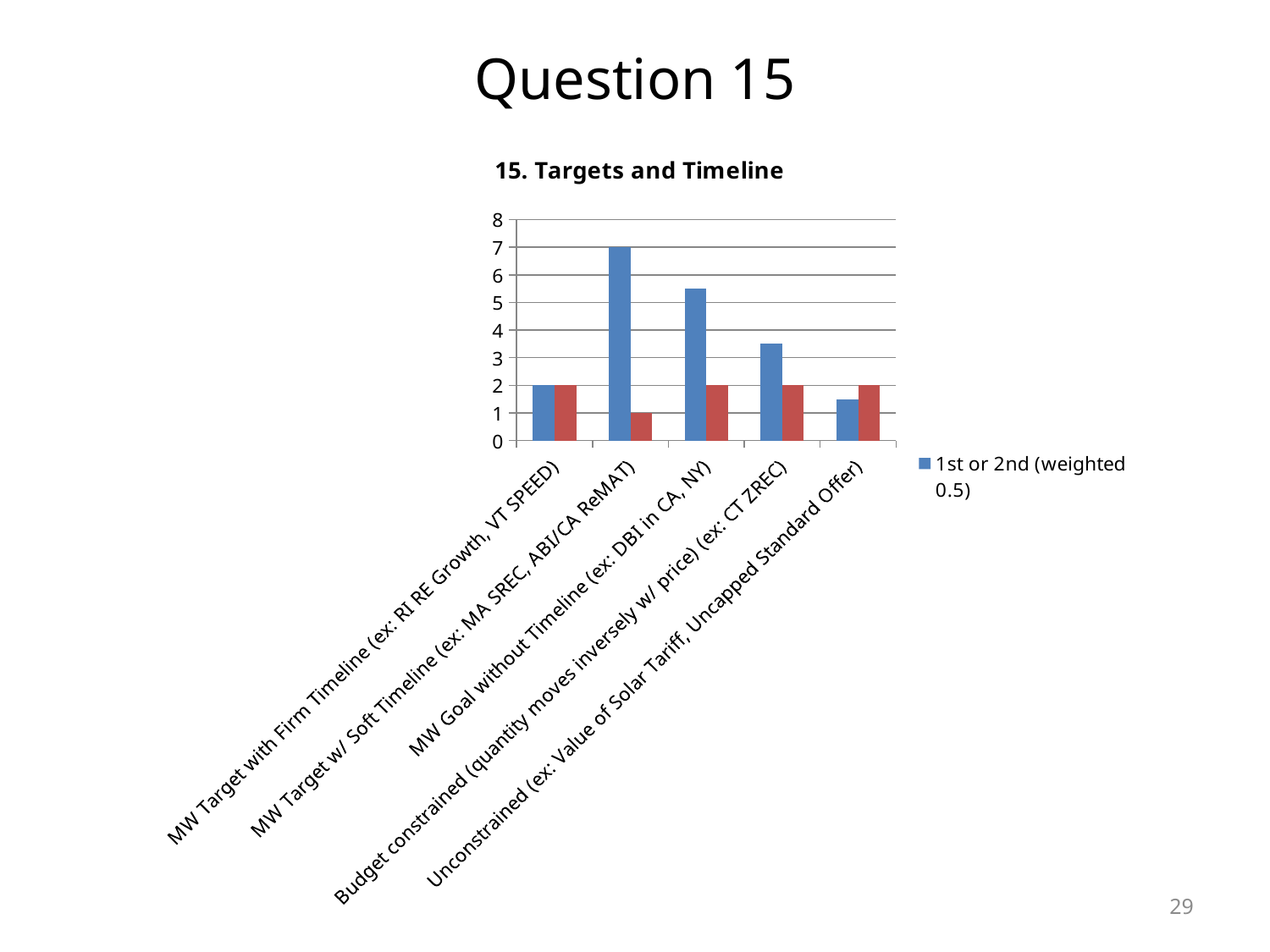
Is the value of the '1st or 2nd (weighted 0.5)' series for 'Budget constrained (quantity moves inversely w/ price) (ex: CT ZREC)' greater or less than 4? less For 'MW Goal without Timeline (ex: DBI in CA, NY)', which bar is larger, the blue bar or the red bar? the blue bar How many series does the chart's legend list? 1 Which category has the highest value for the '1st or 2nd (weighted 0.5)' series? MW Target w/ Soft Timeline (ex: MA SREC, ABI/CA ReMAT) Which category has the lowest value for the '1st or 2nd (weighted 0.5)' series? Unconstrained (ex: Value of Solar Tariff, Uncapped Standard Offer) What is the value of the '1st or 2nd (weighted 0.5)' series for 'MW Target with Firm Timeline (ex: RI RE Growth, VT SPEED)'? 2 What is the title of the chart? 15. Targets and Timeline What type of chart is shown on the slide? bar chart Is the value of the '1st or 2nd (weighted 0.5)' series for 'MW Goal without Timeline (ex: DBI in CA, NY)' greater or less than 5? greater How many categories are shown on the x axis of the chart? 5 What is the value of the red bar for 'MW Target w/ Soft Timeline (ex: MA SREC, ABI/CA ReMAT)'? 1 What is the value of the '1st or 2nd (weighted 0.5)' series for 'MW Target w/ Soft Timeline (ex: MA SREC, ABI/CA ReMAT)'? 7